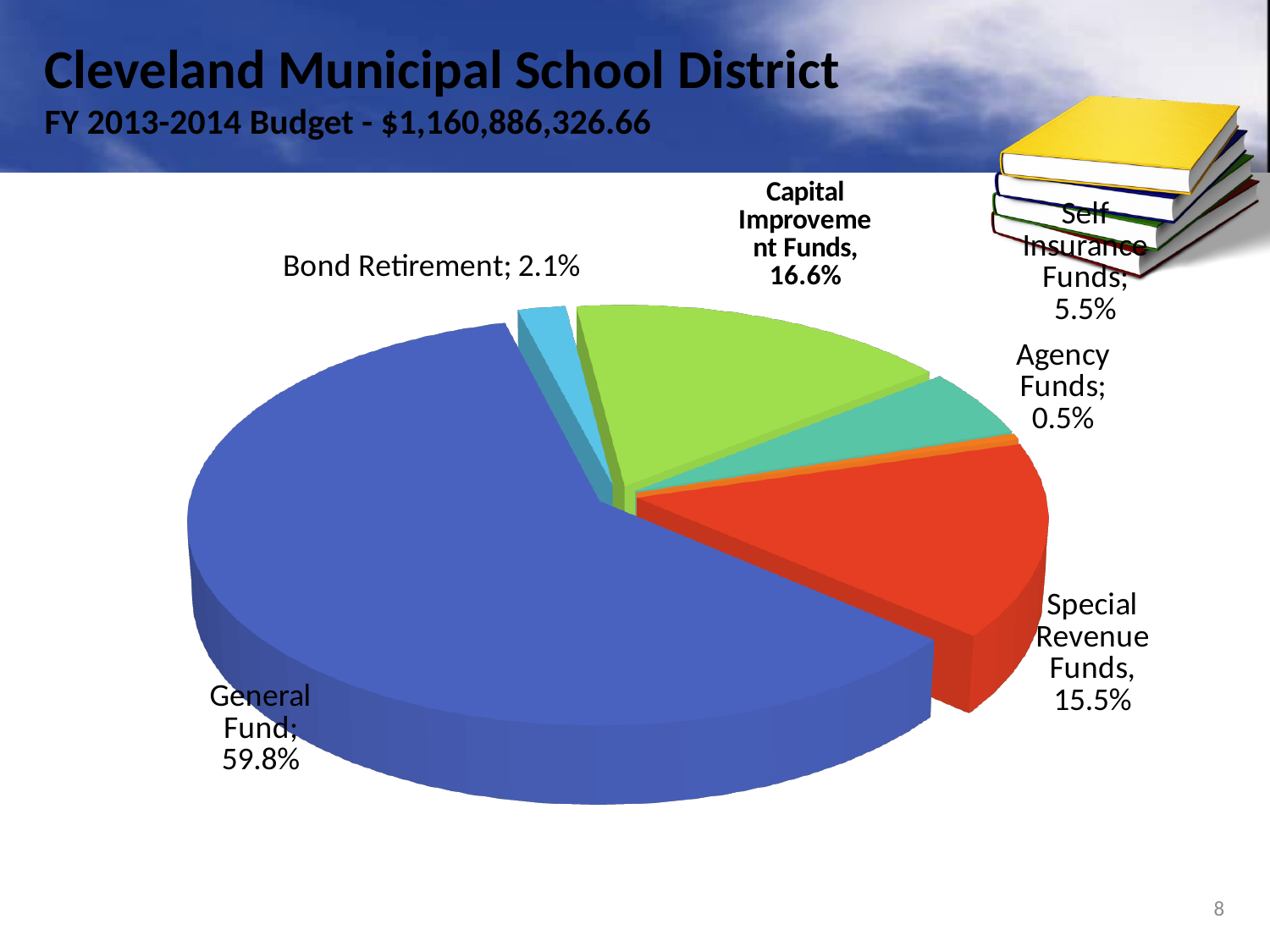
What is the difference in percentage points between Self Insurance Funds and Bond Retirement? 3.4% What kind of chart is shown on the slide? Pie chart Which fund category has the largest share of the pie? General Fund What percentage is shown for Capital Improvement Funds? 16.6% What percentage is shown for Bond Retirement? 2.1% Which fund category has the smallest share of the pie? Agency Funds How many slices does the pie chart have? 6 Which is larger, Capital Improvement Funds or Special Revenue Funds? Capital Improvement Funds What share of the budget does the General Fund represent? 59.8% What percentage is shown for Agency Funds? 0.5% What percentage is shown for Special Revenue Funds? 15.5% What total budget amount is stated in the slide subtitle? $1,160,886,326.66